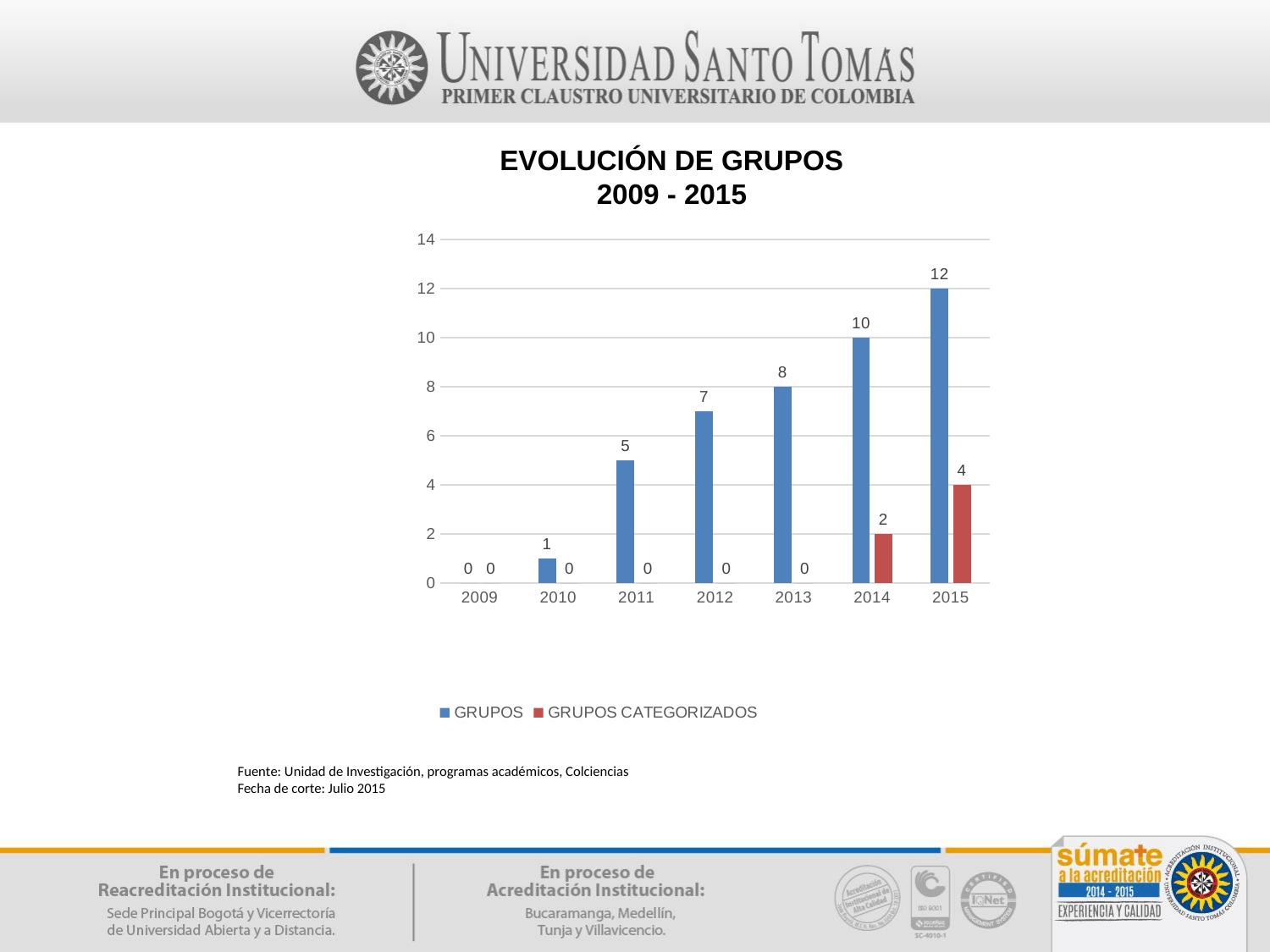
Which year has the highest value for GRUPOS? 2015 How many years are shown on the x axis? 7 What is the value for GRUPOS CATEGORIZADOS in 2015? 4 Do the values for GRUPOS rise or fall from 2009 to 2015? Rise What is the difference between GRUPOS in 2015 and GRUPOS in 2014? 2 What is the difference between GRUPOS and GRUPOS CATEGORIZADOS in 2015? 8 What kind of chart is shown on the slide? Bar chart Which is larger, GRUPOS in 2012 or GRUPOS CATEGORIZADOS in 2015? GRUPOS in 2012 Which year has the lowest value for GRUPOS? 2009 What is the value for GRUPOS in 2011? 5 How many series does the legend list? 2 What is the value for GRUPOS in 2013? 8